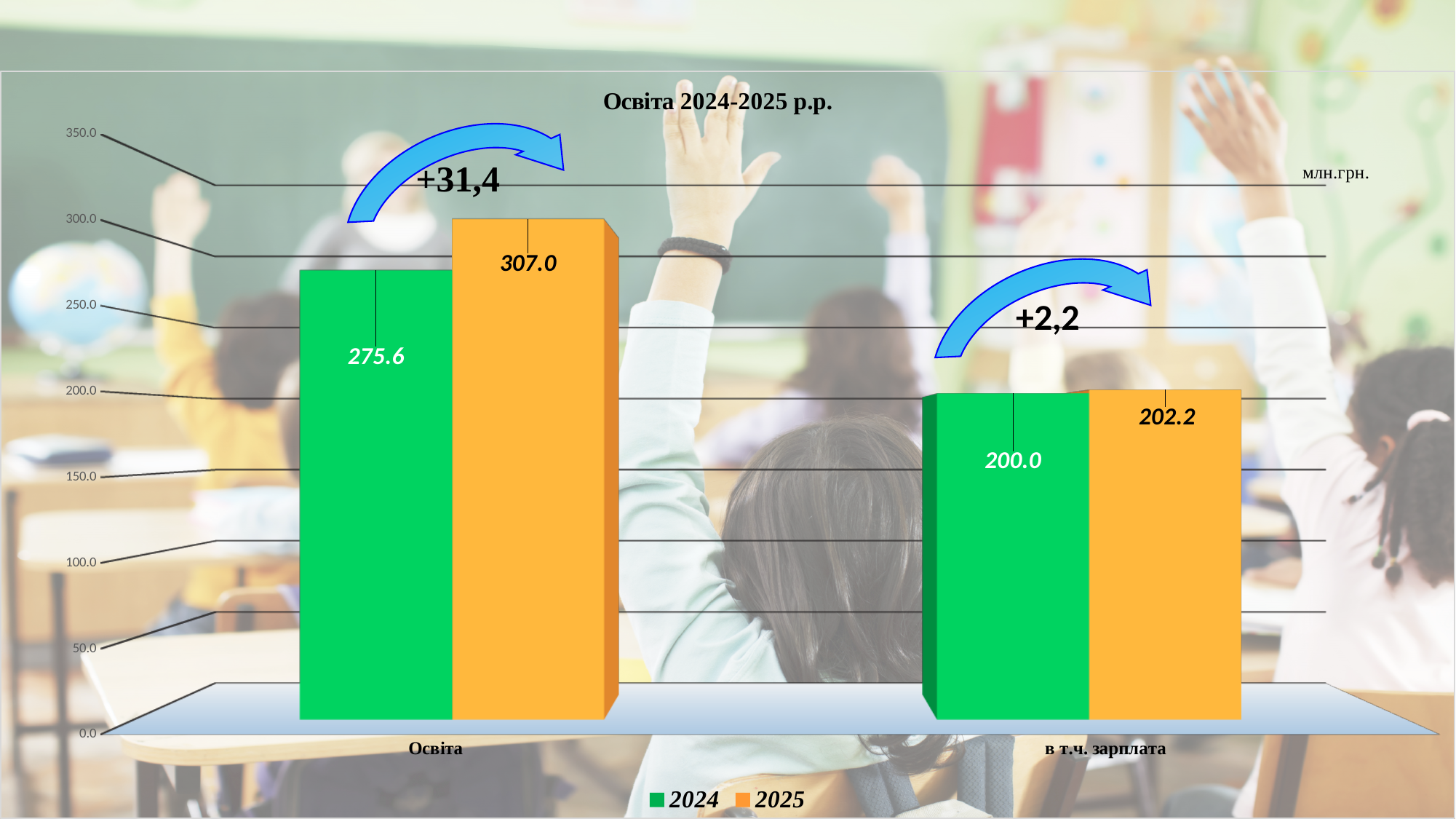
What is the value for 2025 in the "в т.ч. зарплата" category? 202.2 Which bar has the highest value on the chart? 2025, Освіта (307.0) What is the value for 2024 in the "в т.ч. зарплата" category? 200.0 What is the value for 2024 in the "Освіта" category? 275.6 How many categories are shown on the x axis? 2 What kind of chart is shown on the slide? Bar chart What is the value for 2025 in the "Освіта" category? 307.0 What is the difference between the 2025 and 2024 values for "Освіта"? 31.4 What is the title of the chart? Освіта 2024-2025 р.р. Which bar has the lowest value on the chart? 2024, в т.ч. зарплата (200.0) How many series does the legend list? 2 Which is larger for "Освіта": the 2024 value or the 2025 value? 2025